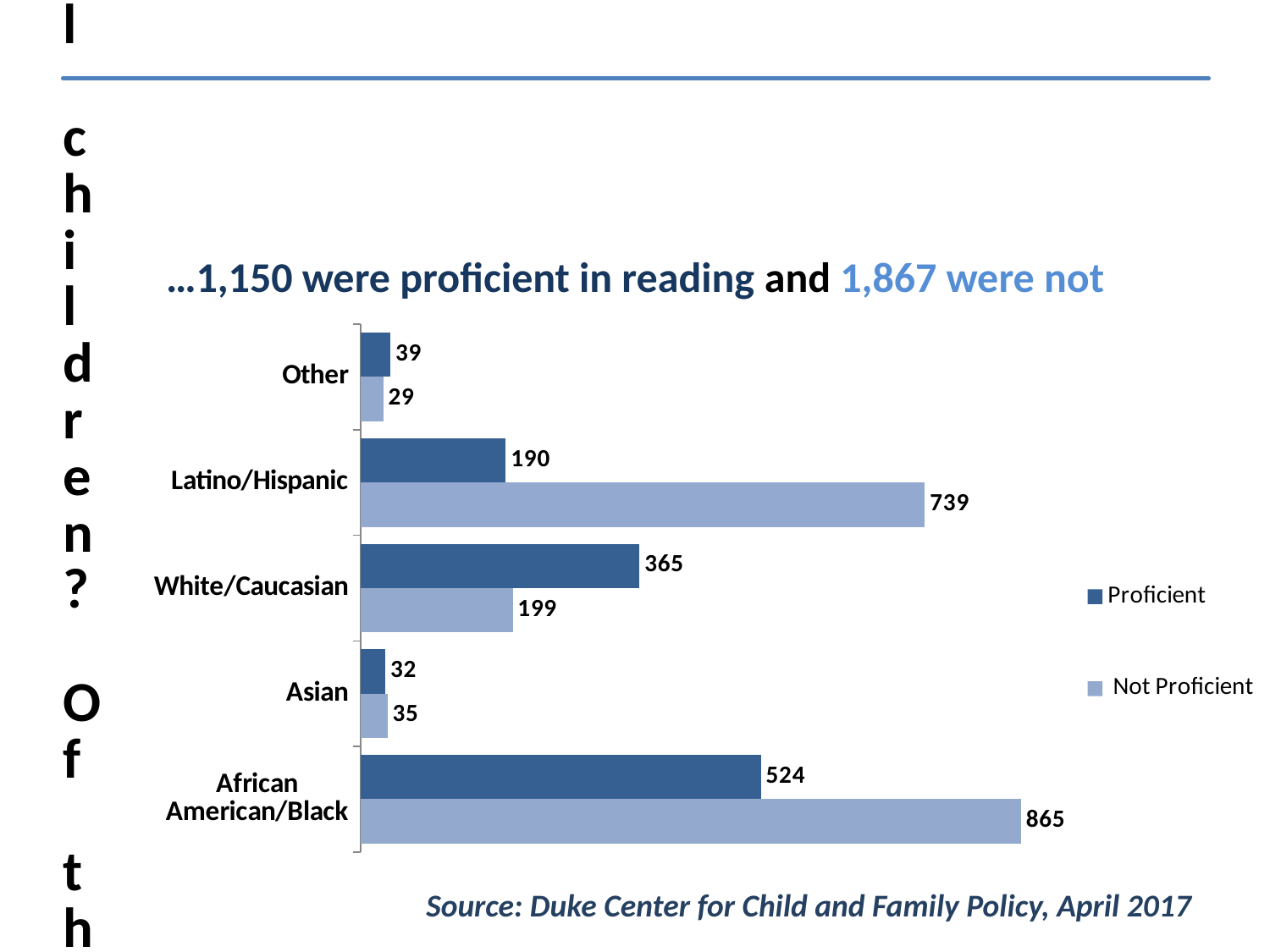
What kind of chart is shown on the slide? Bar chart Which category has the highest Proficient value? African American/Black How many series does the legend list? 2 Which category has the lowest Not Proficient value? Other What is the Not Proficient value for White/Caucasian? 199 How many categories are shown on the chart? 5 Which is larger for White/Caucasian, the Proficient value or the Not Proficient value? Proficient What is the Proficient value for Latino/Hispanic? 190 What is the total of the Proficient and Not Proficient values for Asian? 67 What is the difference between the Not Proficient and Proficient values for Latino/Hispanic? 549 What is the Not Proficient value for African American/Black? 865 What are the two series named in the legend? Proficient and Not Proficient